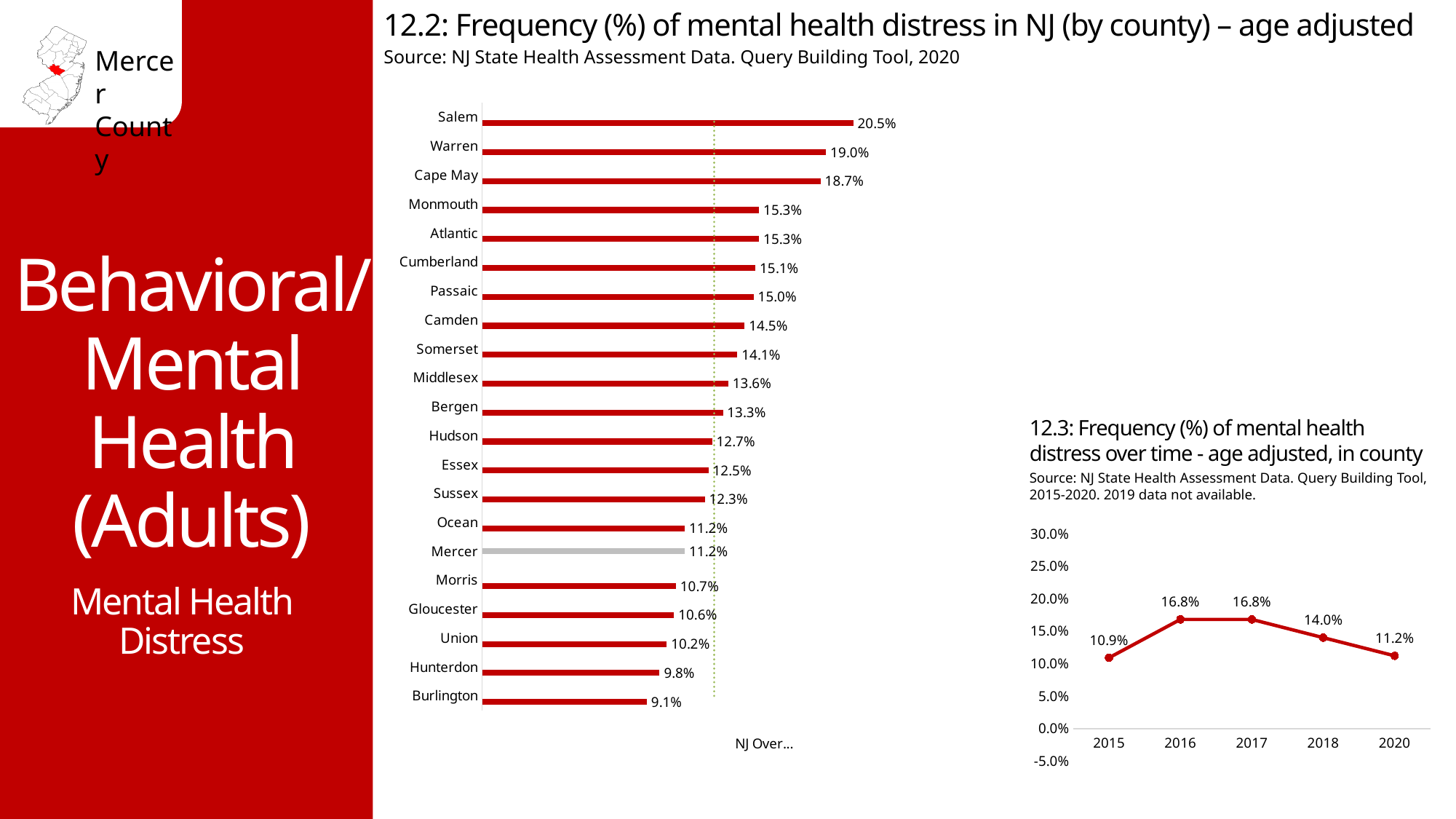
In chart 12.2 (Frequency of mental health distress in NJ by county), which county has the highest value? Salem In chart 12.2 (Frequency of mental health distress in NJ by county), what is the difference between Salem and Burlington? 11.4% In chart 12.3 (Frequency of mental health distress over time in county), which year has the lowest value? 2015 In chart 12.2 (Frequency of mental health distress in NJ by county), what is the value for Mercer? 11.2% In chart 12.3 (Frequency of mental health distress over time in county), what is the value for 2018? 14.0% In chart 12.3 (Frequency of mental health distress over time in county), what is the difference between 2017 and 2020? 5.6% What kind of chart is chart 12.2 (Frequency of mental health distress in NJ by county)? Bar chart What kind of chart is chart 12.3 (Frequency of mental health distress over time in county)? Line chart In chart 12.2 (Frequency of mental health distress in NJ by county), how many counties are shown? 21 In chart 12.2 (Frequency of mental health distress in NJ by county), which is larger, Cape May or Monmouth? Cape May In chart 12.2 (Frequency of mental health distress in NJ by county), what is the value for Hunterdon? 9.8% In chart 12.2 (Frequency of mental health distress in NJ by county), which county has the lowest value? Burlington